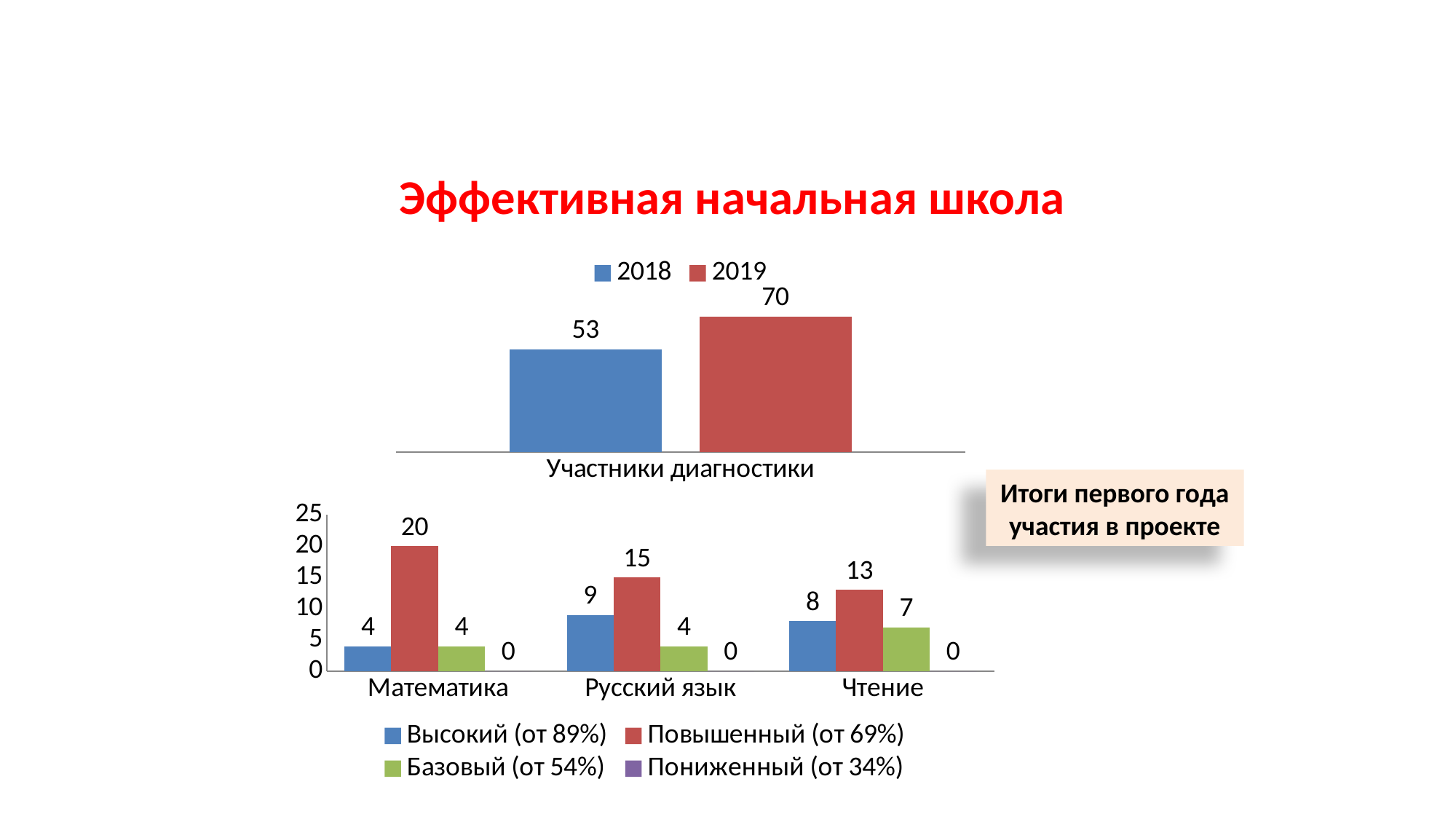
In the bottom chart, what is the difference between Повышенный (от 69%) and Высокий (от 89%) for Чтение? 5 In the bottom chart, which subject has the lowest value for Высокий (от 89%)? Математика In the bottom chart, what is the value of Высокий (от 89%) for Русский язык? 9 In the top chart, which year has the larger value, 2018 or 2019? 2019 In the top chart, what is the value for 2019? 70 In the bottom chart, what is the value of Повышенный (от 69%) for Математика? 20 In the bottom chart, which subject has the highest value for Повышенный (от 69%)? Математика In the top chart, what is the value for 2018 for Участники диагностики? 53 How many series does the legend of the bottom chart list? 4 What type of chart is the bottom chart? Bar chart In the bottom chart, what is the value of Базовый (от 54%) for Чтение? 7 In the top chart, what is the difference between the 2019 and 2018 values? 17